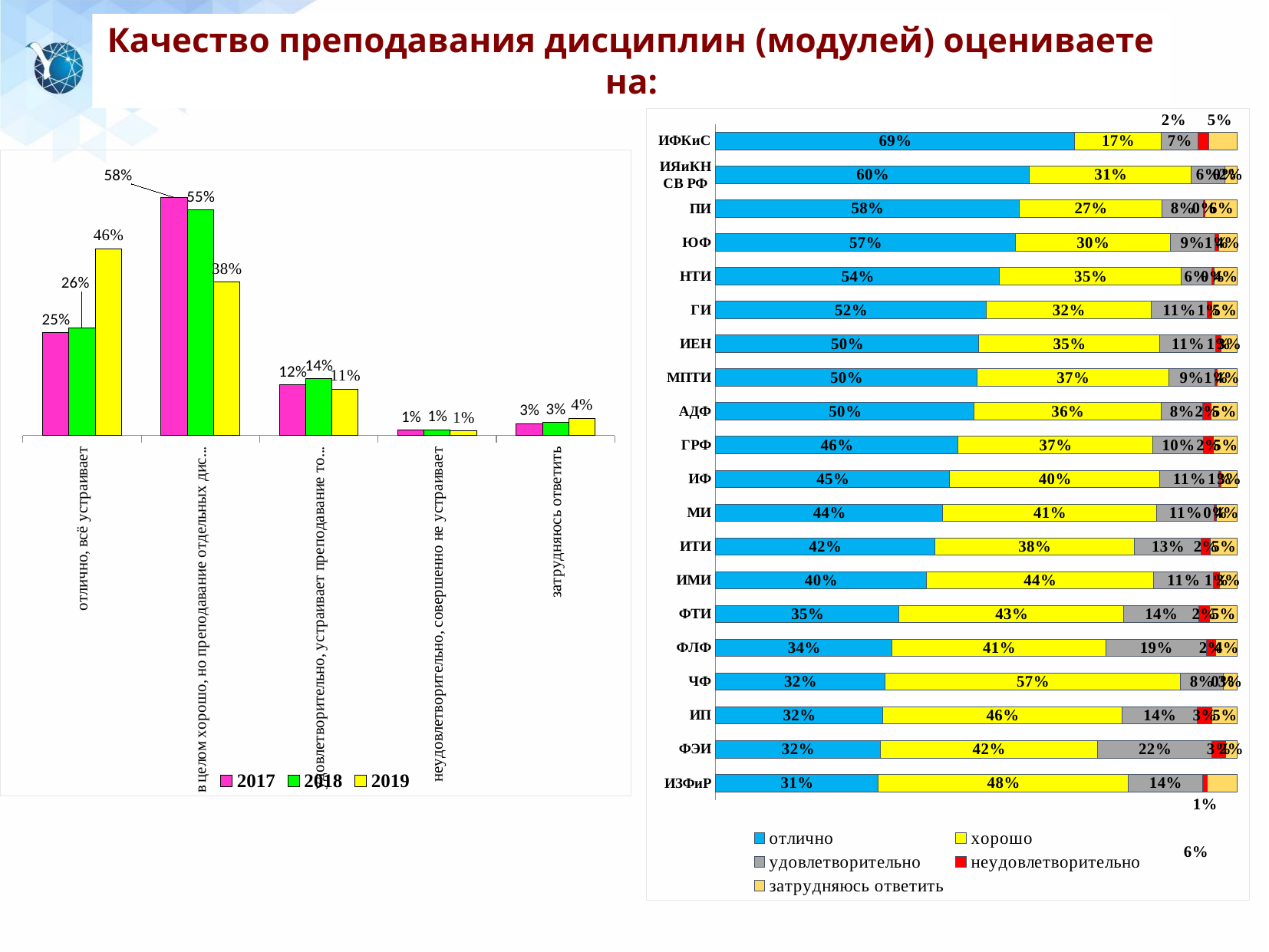
On the left chart, how many series does the legend list? 3 On the right chart, which institute has the highest "отлично" value? ИФКиС On the right chart, which institute has the lowest "отлично" value? ИЗФиР On the left chart, which year has the highest value for "затрудняюсь ответить"? 2019 On the left chart, what is the 2019 value for "отлично, всё устраивает"? 46% On the left chart, what is the difference between the 2019 and 2017 values for "отлично, всё устраивает"? 21% On the right chart, what is the "хорошо" value for ЧФ? 57% On the right chart, how many series does the legend list? 5 On the right chart, which is larger: the "удовлетворительно" value for ФЭИ or for ФЛФ? ФЭИ On the right chart, what is the "отлично" value for ИФКиС? 69% What kind of chart is the right chart? Stacked bar chart On the left chart, what is the 2017 value for "в целом хорошо, но преподавание отдельных дис..."? 58%